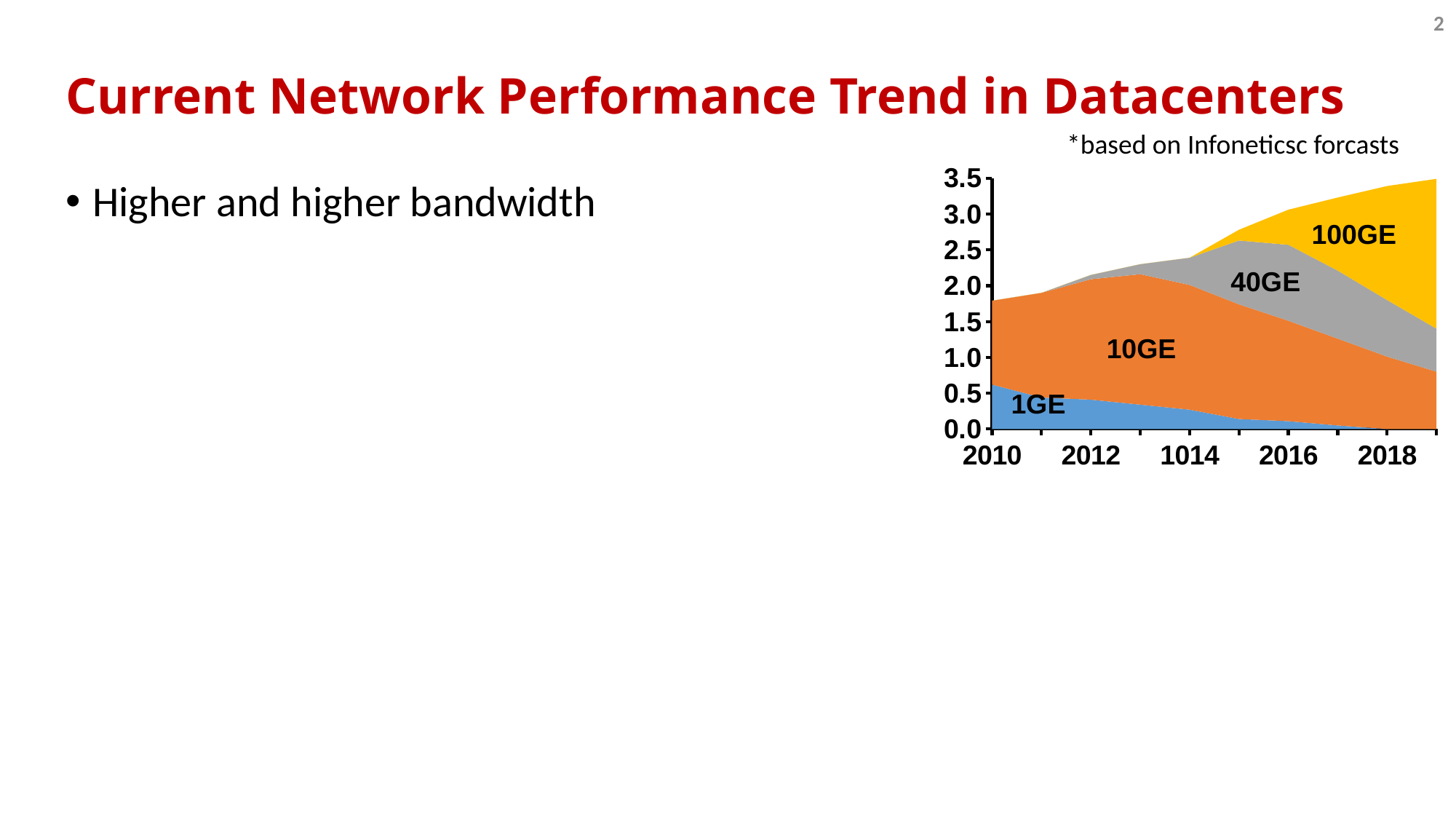
Which series is plotted at the bottom of the stacked area chart? 1GE How many series (bandwidth categories) are labelled in the chart? 4 What is the highest value shown on the y axis? 3.5 Does the 1GE area rise or fall from 2010 to 2018? Fall What kind of chart is shown on the slide? Stacked area chart Is the total stacked value in 2010 greater or less than 2.0? less Does the 100GE area rise or fall from 2016 to 2018? Rise Is the total stacked value in 2018 greater or less than 3.0? greater Is the value for 1GE in 2018 greater or less than 0.5? less Which series is larger in 2018, 1GE or 100GE? 100GE Which series is plotted at the top of the stacked area chart? 100GE